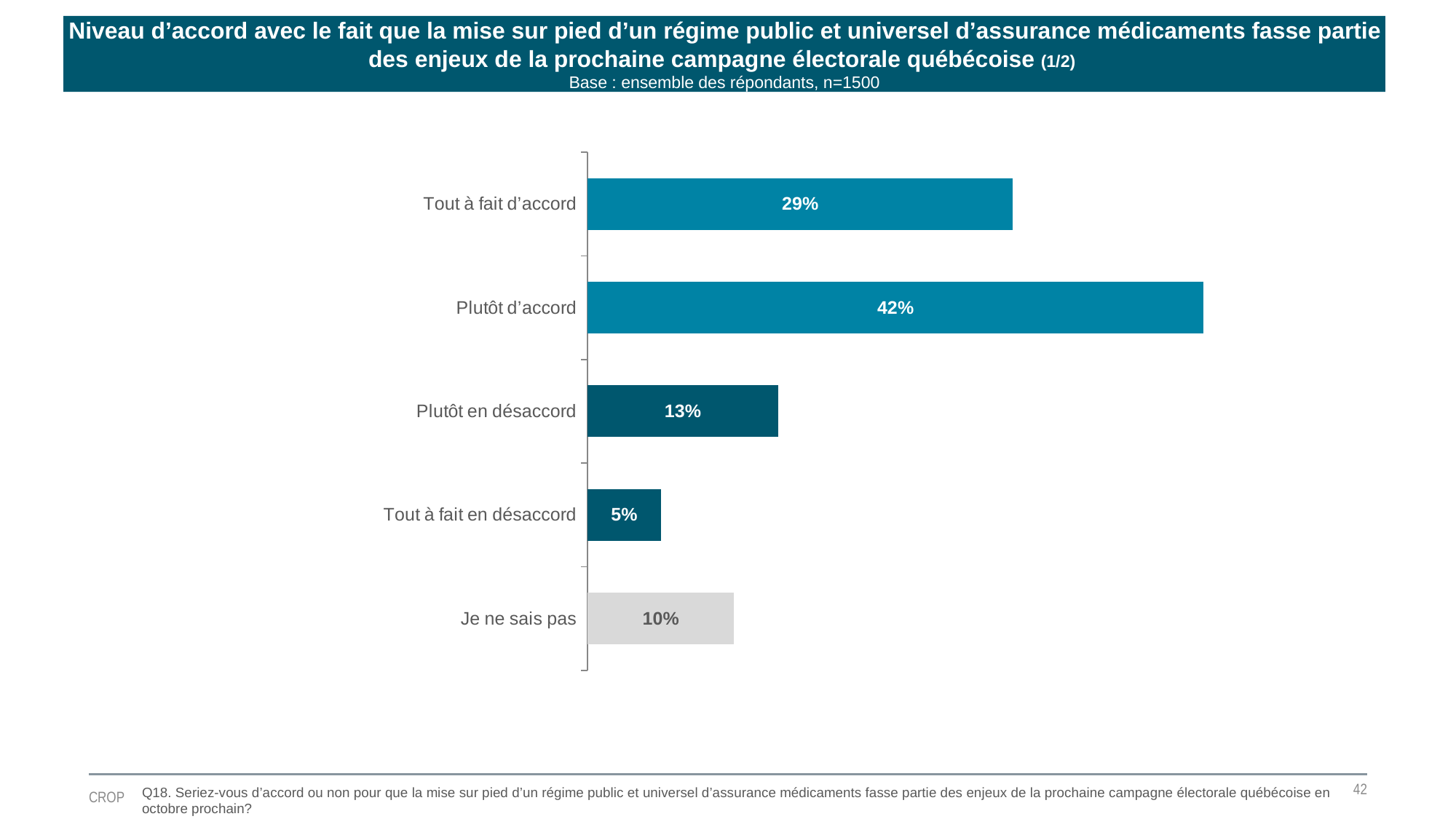
What is the value for "Tout à fait d'accord"? 29% How many categories are shown in the chart? 5 What is the difference between "Plutôt en désaccord" and "Tout à fait en désaccord"? 8% Which is larger, "Plutôt en désaccord" or "Je ne sais pas"? Plutôt en désaccord Which category has the highest value? Plutôt d'accord What is the value for "Je ne sais pas"? 10% What kind of chart is shown on the slide? Bar chart What is the difference between "Plutôt d'accord" and "Tout à fait d'accord"? 13% Which category has the lowest value? Tout à fait en désaccord What is the value for "Tout à fait en désaccord"? 5% What is the base (number of respondents) stated under the chart title? n=1500 What is the value for "Plutôt d'accord"? 42%